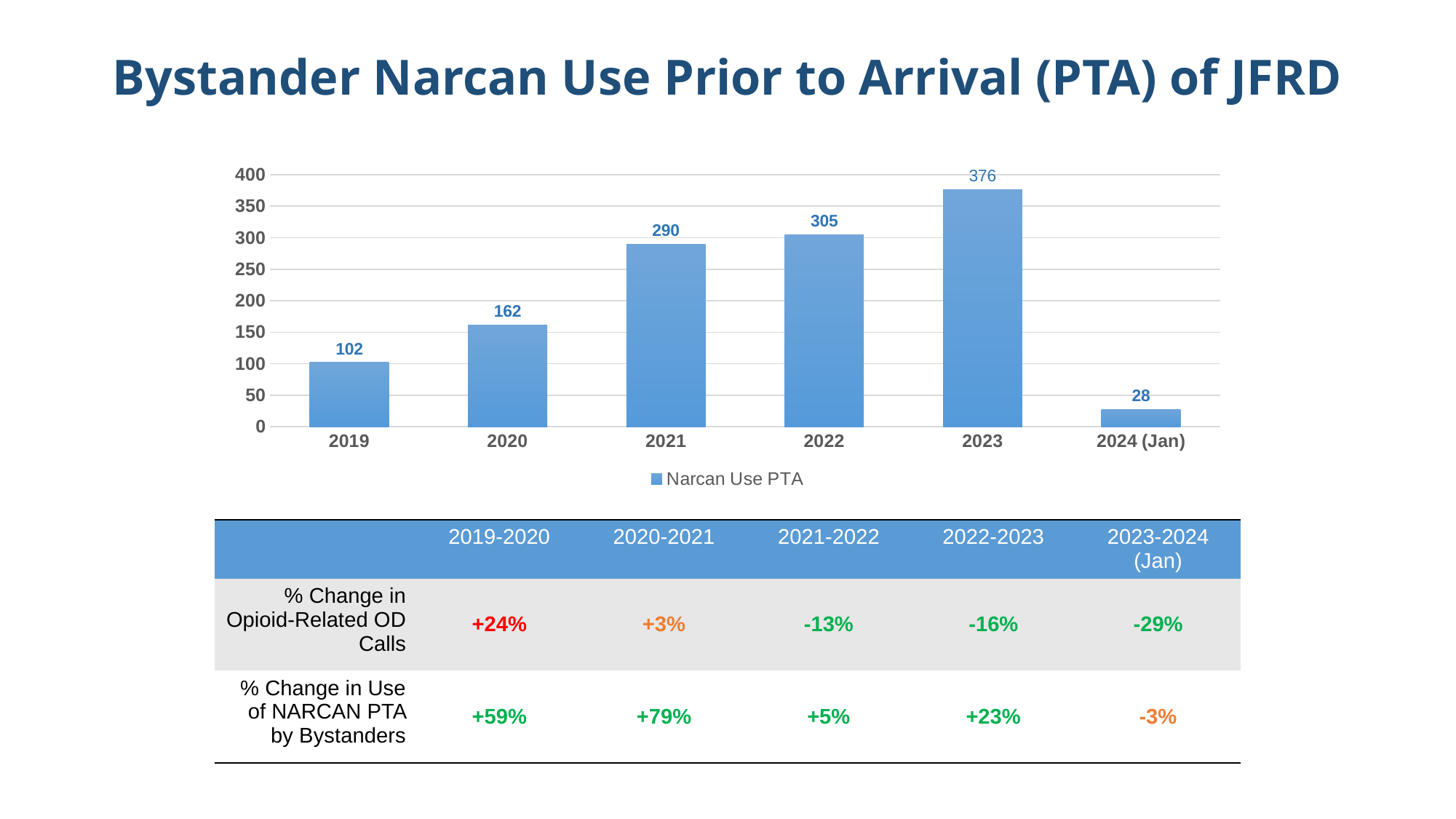
Which year has the highest Narcan Use PTA value? 2023 What is the difference between the Narcan Use PTA values for 2023 and 2022? 71 What is the Narcan Use PTA value for 2021? 290 Is the Narcan Use PTA value for 2023 greater or less than 350? greater What is the Narcan Use PTA value for 2024 (Jan)? 28 How many categories are shown on the x axis of the chart? 6 What is the difference between the Narcan Use PTA values for 2020 and 2019? 60 What kind of chart is shown on the slide? Bar chart What series name is listed in the chart legend? Narcan Use PTA Which category has the lowest Narcan Use PTA value? 2024 (Jan) What is the Narcan Use PTA value for 2019? 102 Which is larger, the Narcan Use PTA value for 2021 or for 2022? 2022